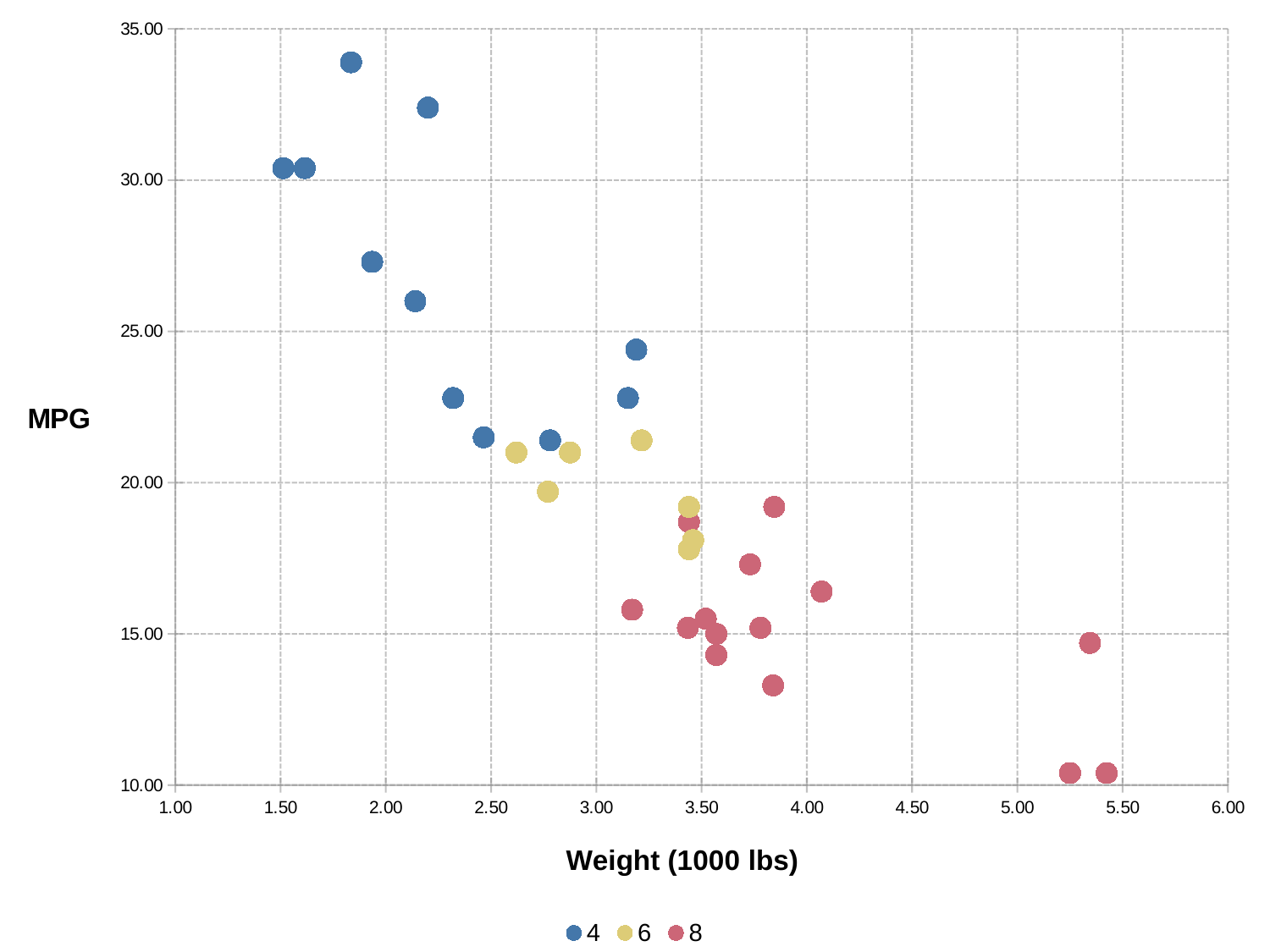
Is the MPG of the highest point in series 4 greater or less than 30? greater How many series does the legend list? 3 Are the MPG values of the two lowest points in series 8 greater or less than 15? less What are the series names shown in the legend? 4, 6, 8 Which series contains the point with the highest MPG? 4 What kind of chart is shown on the slide? Scatter chart Which series contains the heaviest vehicles (largest weight values)? 8 What is the title of the horizontal axis? Weight (1000 lbs) How many points have a weight greater than 5.00? 3 Which series contains the points with the lowest MPG? 8 How many points have an MPG above 30? 4 As weight increases along the x axis, does MPG generally rise or fall? Fall